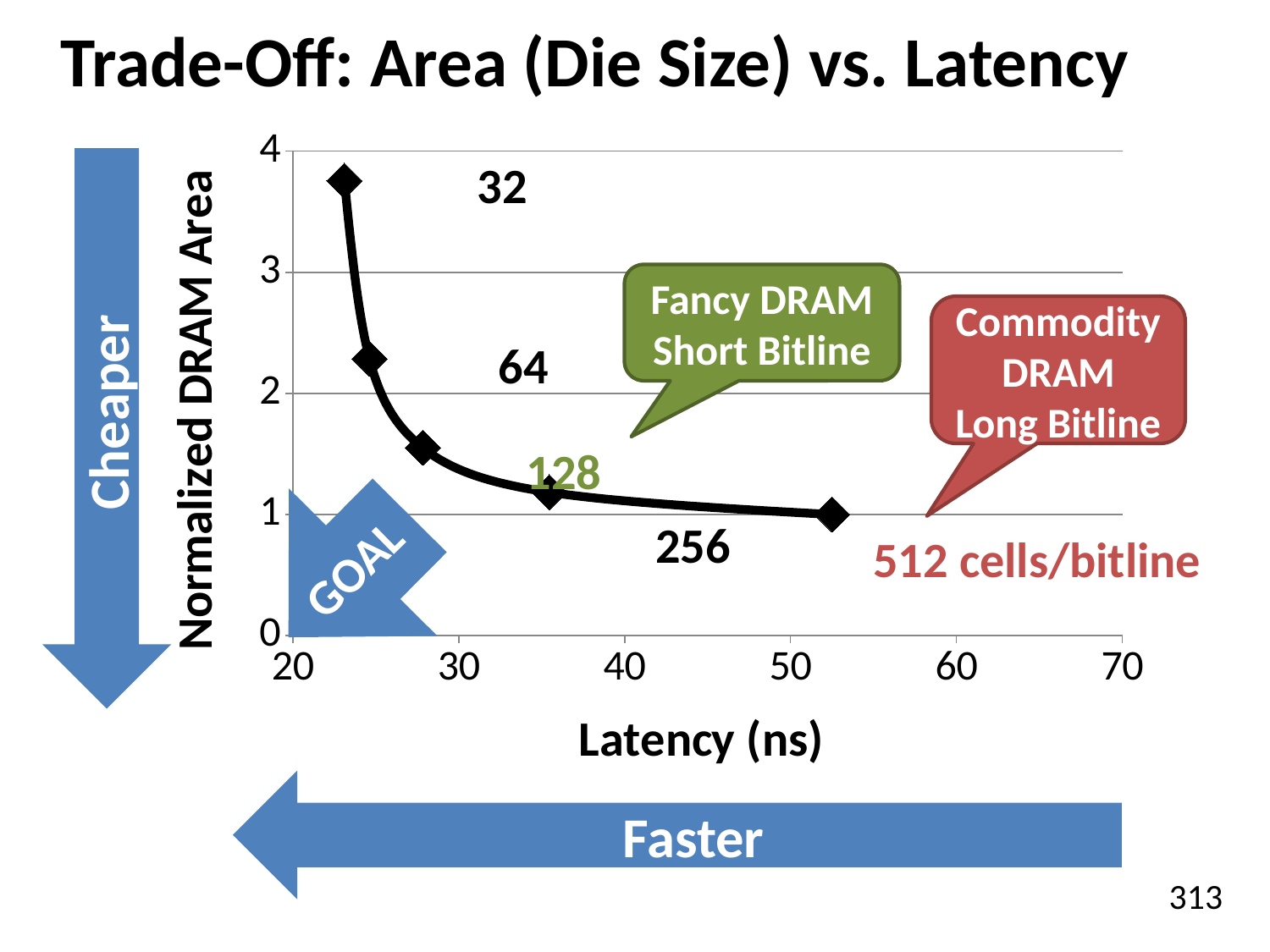
Is the latency for 256 cells/bitline greater or less than 40 ns? less As latency increases along the x axis, does the normalized DRAM area rise or fall? fall Is the normalized DRAM area for 64 cells/bitline greater or less than 2? greater Is the latency for 512 cells/bitline greater or less than 50 ns? greater What kind of chart is shown on the slide? line chart Which has the larger normalized DRAM area, 64 cells/bitline or 128 cells/bitline? 64 cells/bitline Which cells/bitline configuration has the lowest normalized DRAM area? 512 Which cells/bitline configuration has the highest normalized DRAM area? 32 How many data points are plotted on the chart? 5 What is the title of the x axis? Latency (ns)